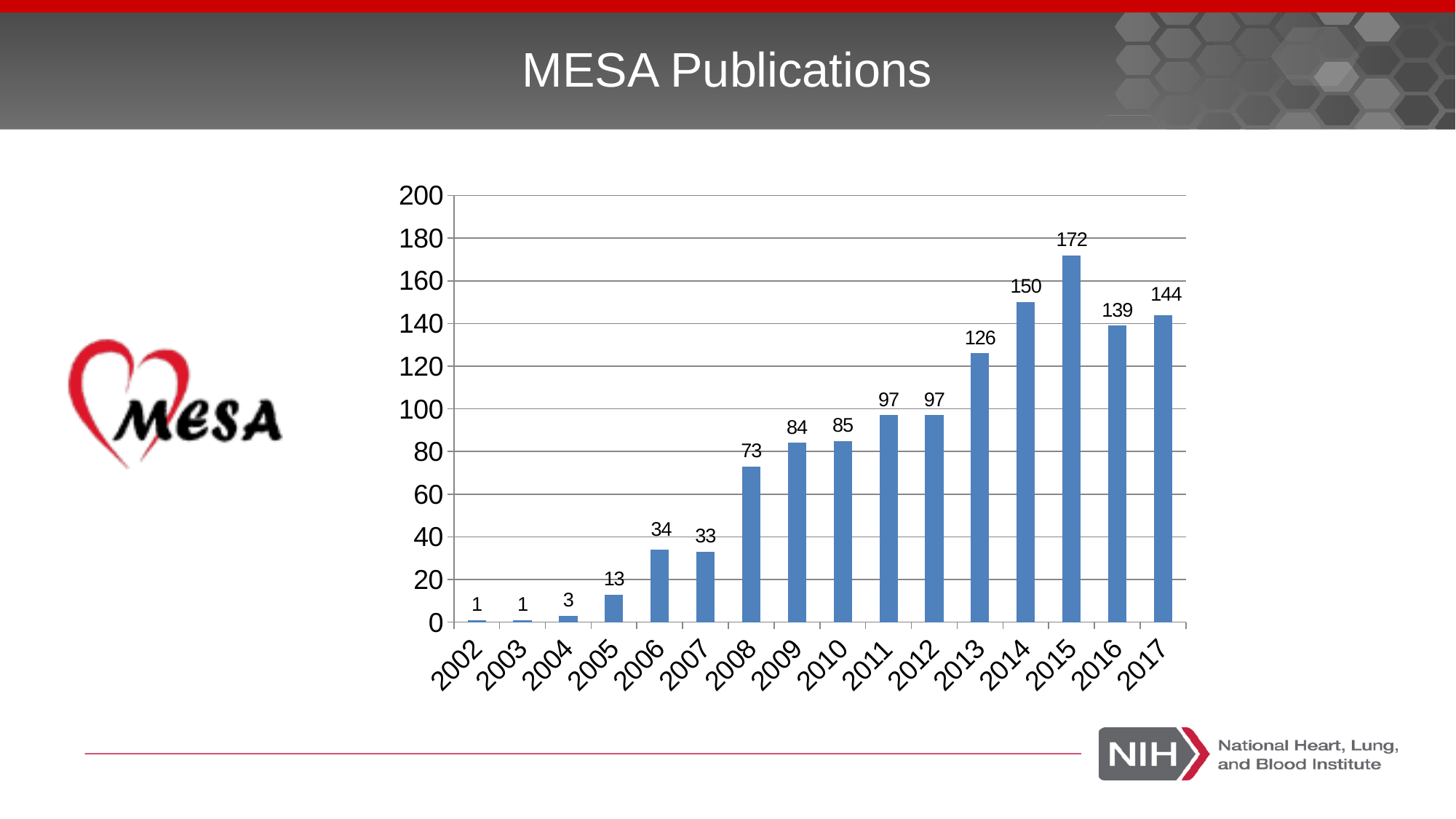
Which is larger, the value for 2006 or the value for 2007? 2006 What is the value for 2017? 144 What is the difference between the values for 2013 and 2012? 29 Which year has the highest value? 2015 What is the title of the slide containing the chart? MESA Publications What is the value for 2008? 73 What kind of chart is shown on the slide? bar chart What is the value for 2015? 172 Do the values generally rise or fall from 2002 to 2015? rise What is the difference between the values for 2015 and 2016? 33 How many years are shown on the x axis? 16 Is the value for 2014 greater or less than 140? greater